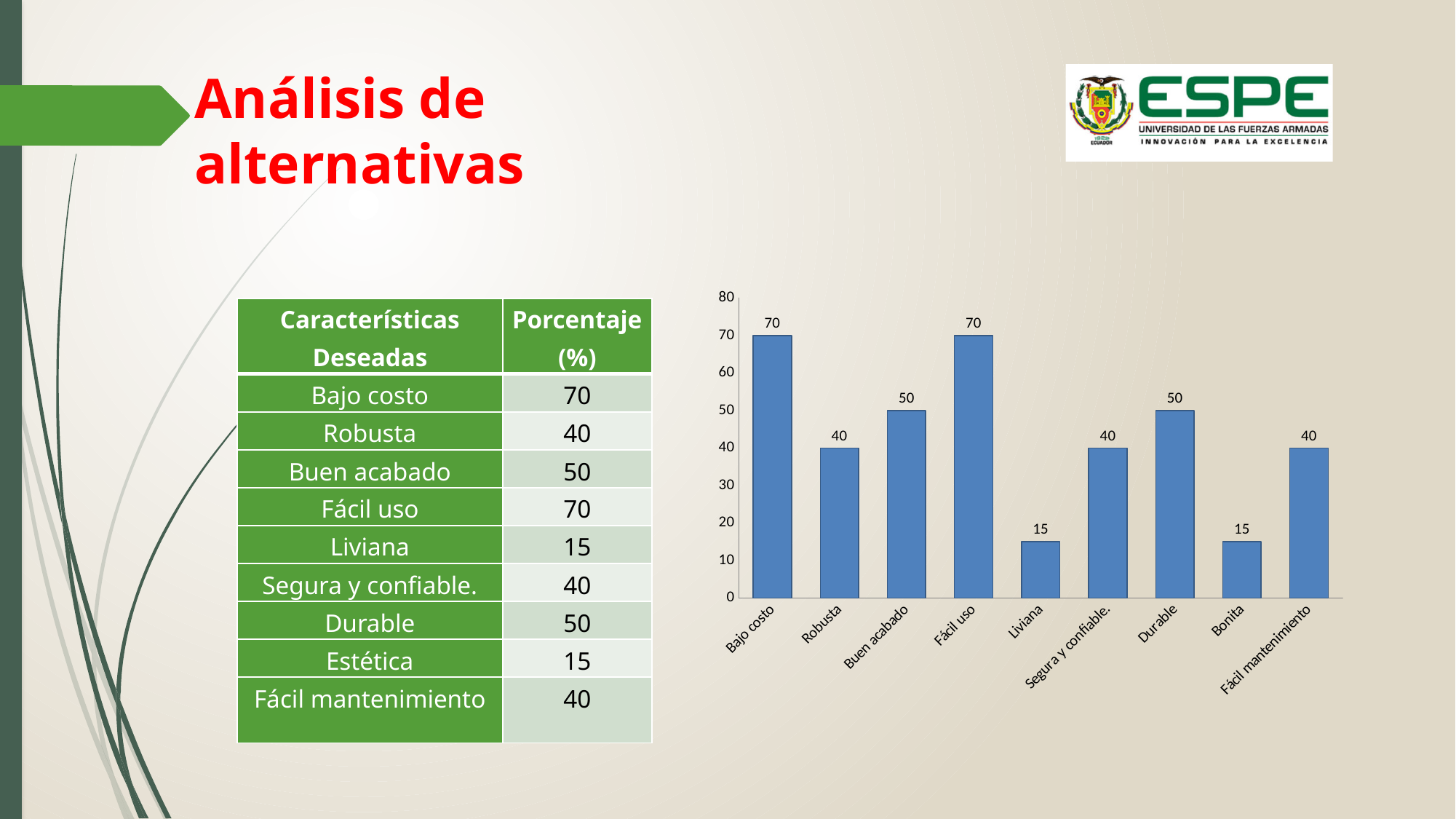
What kind of chart is shown on the slide? bar chart What is the value for Fácil mantenimiento in the bar chart? 40 Is the value for Bajo costo in the bar chart greater or less than 60? greater What is the value for Bajo costo in the bar chart? 70 What is the highest value shown in the bar chart? 70 How many categories are shown in the bar chart? 9 What is the value for Bonita in the bar chart? 15 What is the value for Durable in the bar chart? 50 What is the lowest value shown in the bar chart? 15 Which has a larger value in the bar chart, Buen acabado or Segura y confiable.? Buen acabado What is the value for Liviana in the bar chart? 15 What is the difference between the values for Fácil uso and Robusta in the bar chart? 30